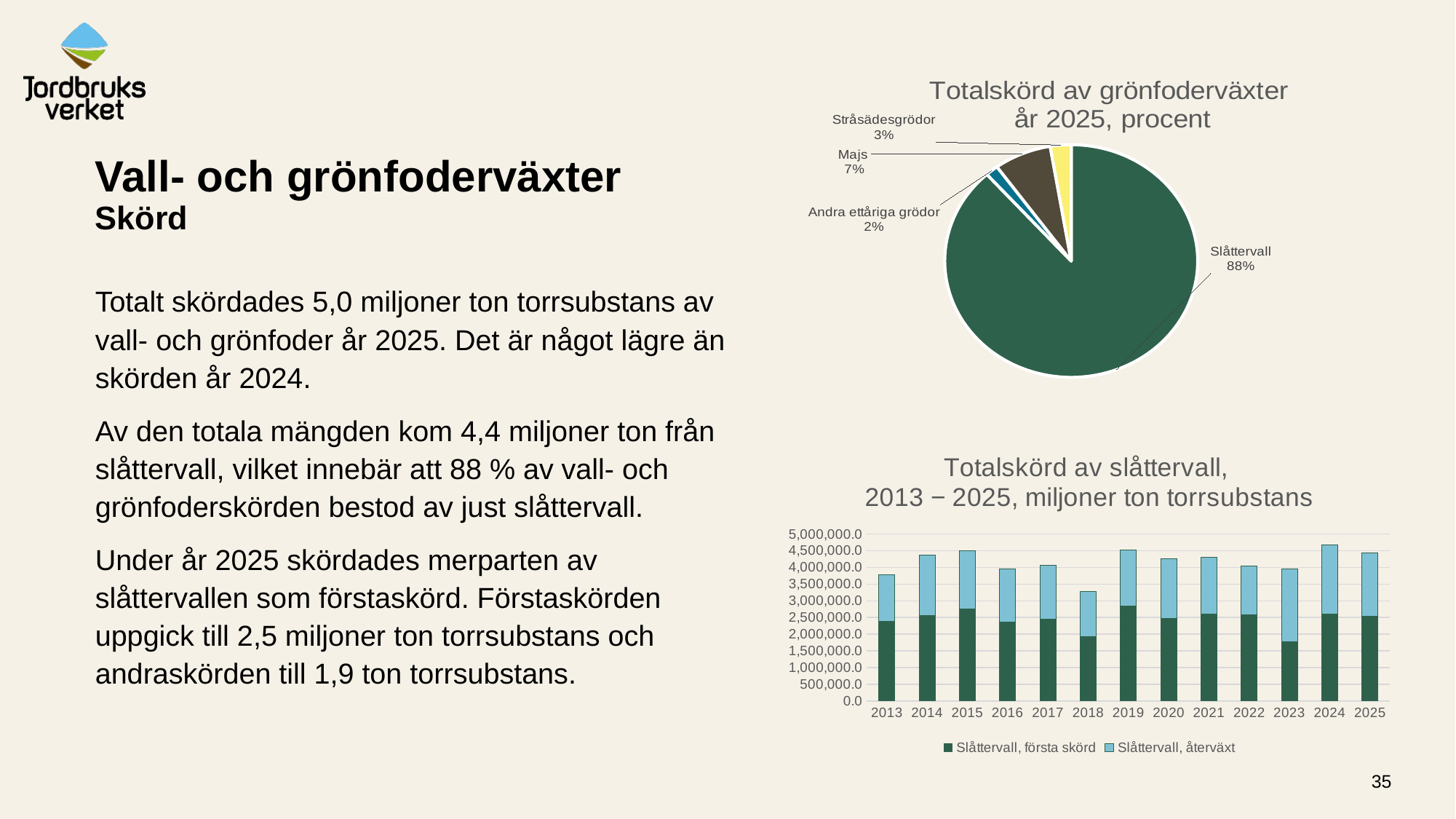
In the pie chart 'Totalskörd av grönfoderväxter år 2025, procent', which category has the smallest share? Andra ettåriga grödor In the pie chart 'Totalskörd av grönfoderväxter år 2025, procent', what share does Majs have? 7% How many years are shown on the x axis of the chart 'Totalskörd av slåttervall, 2013 − 2025'? 13 In the pie chart 'Totalskörd av grönfoderväxter år 2025, procent', what is the difference in percentage points between Majs and Stråsädesgrödor? 4 percentage points In the chart 'Totalskörd av slåttervall, 2013 − 2025', is the total value for 2018 greater or less than 3,500,000.0? less In the pie chart 'Totalskörd av grönfoderväxter år 2025, procent', which category has the largest share? Slåttervall In the chart 'Totalskörd av slåttervall, 2013 − 2025', which year has the lowest total bar? 2018 How many slices does the pie chart 'Totalskörd av grönfoderväxter år 2025, procent' have? 4 In the pie chart 'Totalskörd av grönfoderväxter år 2025, procent', what share does Slåttervall have? 88% In the chart 'Totalskörd av slåttervall, 2013 − 2025', which year has the highest total bar? 2024 How many series does the legend of the chart 'Totalskörd av slåttervall, 2013 − 2025' list? 2 What kind of chart is 'Totalskörd av slåttervall, 2013 − 2025, miljoner ton torrsubstans'? Stacked bar chart